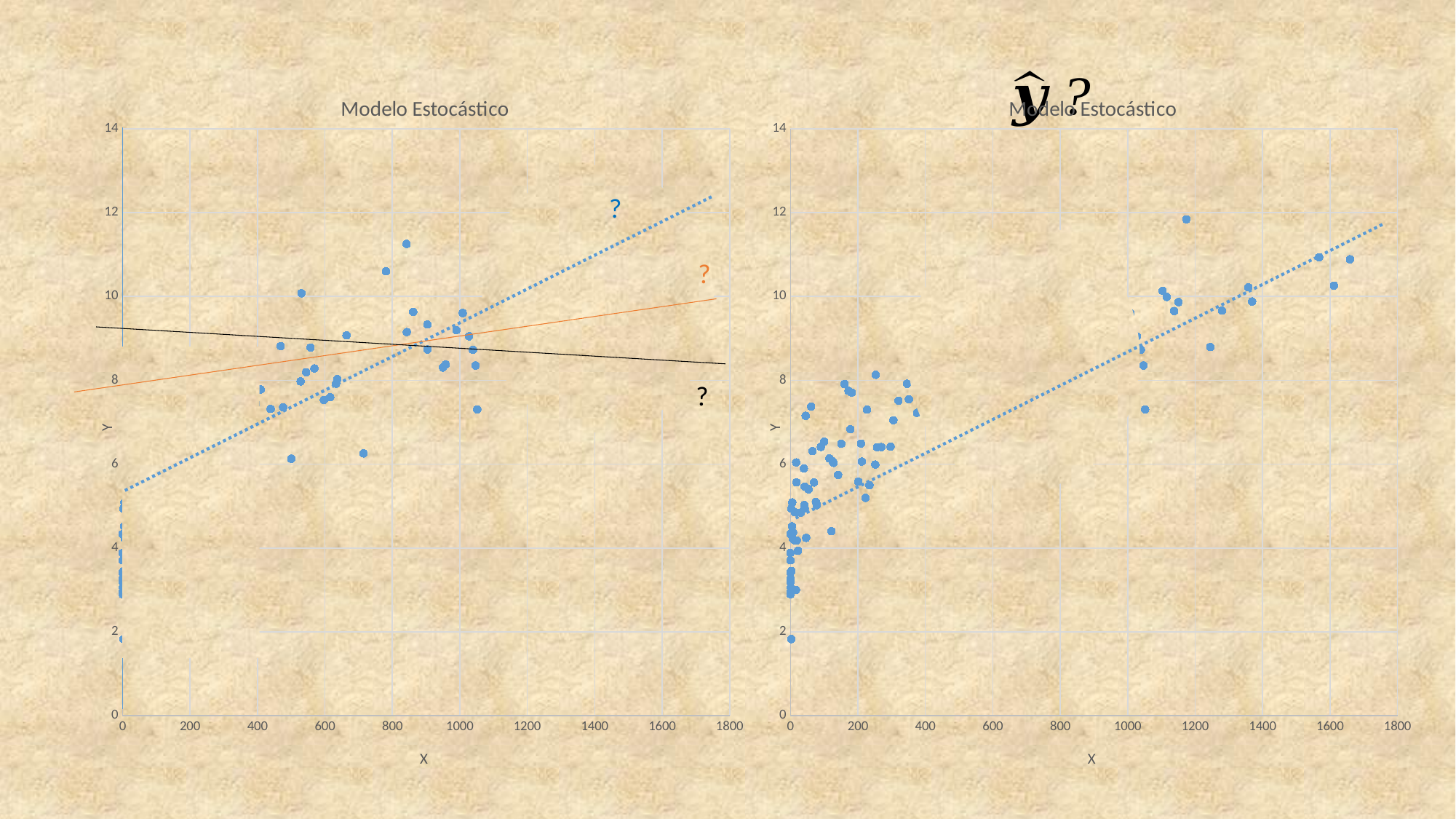
What kind of chart is the right chart on the slide? scatter chart How many fitted lines are drawn on the left chart? 3 On the left chart, does the black line rise or fall as X increases? fall On the left chart, what is the maximum value shown on the vertical axis? 14 On the right chart, is the lowest plotted point greater or less than 4 on the Y axis? less How many fitted lines are drawn on the right chart? 1 What is the title of the left chart? Modelo Estocástico On the right chart, is the highest plotted point greater or less than 10 on the Y axis? greater What is the label of the horizontal axis on the right chart? X What kind of chart is the left chart on the slide? scatter chart On the right chart, what is the maximum value shown on the horizontal axis? 1800 On the right chart, does the blue dotted line rise or fall as X increases? rise